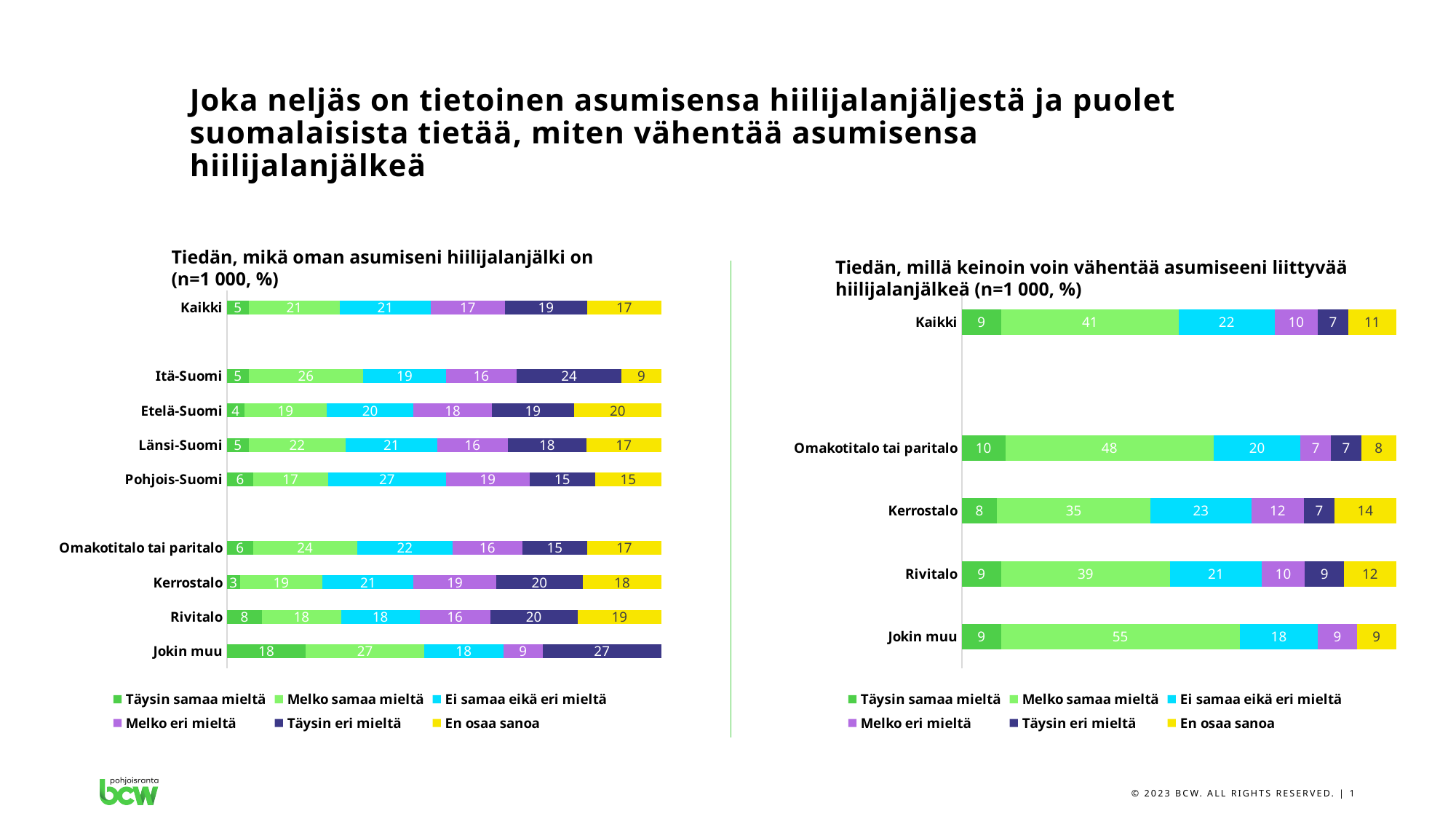
In the left chart (Tiedän, mikä oman asumiseni hiilijalanjälki on), what is the value of 'Melko samaa mieltä' for Itä-Suomi? 26 What kind of chart is the left chart? Stacked bar chart In the right chart, which category has the highest value for 'Melko samaa mieltä'? Jokin muu In the left chart, which category has the lowest value for 'Täysin samaa mieltä'? Kerrostalo In the left chart, what is the 'En osaa sanoa' value for Etelä-Suomi? 20 How many series does the legend of the left chart list? 6 In the right chart, what is the total of the 'Täysin samaa mieltä' and 'Melko samaa mieltä' segments for Kaikki? 50 In the right chart, which is larger: the 'En osaa sanoa' value for Kerrostalo or for Rivitalo? Kerrostalo In the right chart (Tiedän, millä keinoin voin vähentää asumiseeni liittyvää hiilijalanjälkeä), what is the value of 'Melko samaa mieltä' for Omakotitalo tai paritalo? 48 In the left chart, what is the difference between the 'Täysin eri mieltä' values for Itä-Suomi and Pohjois-Suomi? 9 How many categories are shown in the right chart? 5 What colour represents 'En osaa sanoa' in the charts? Yellow